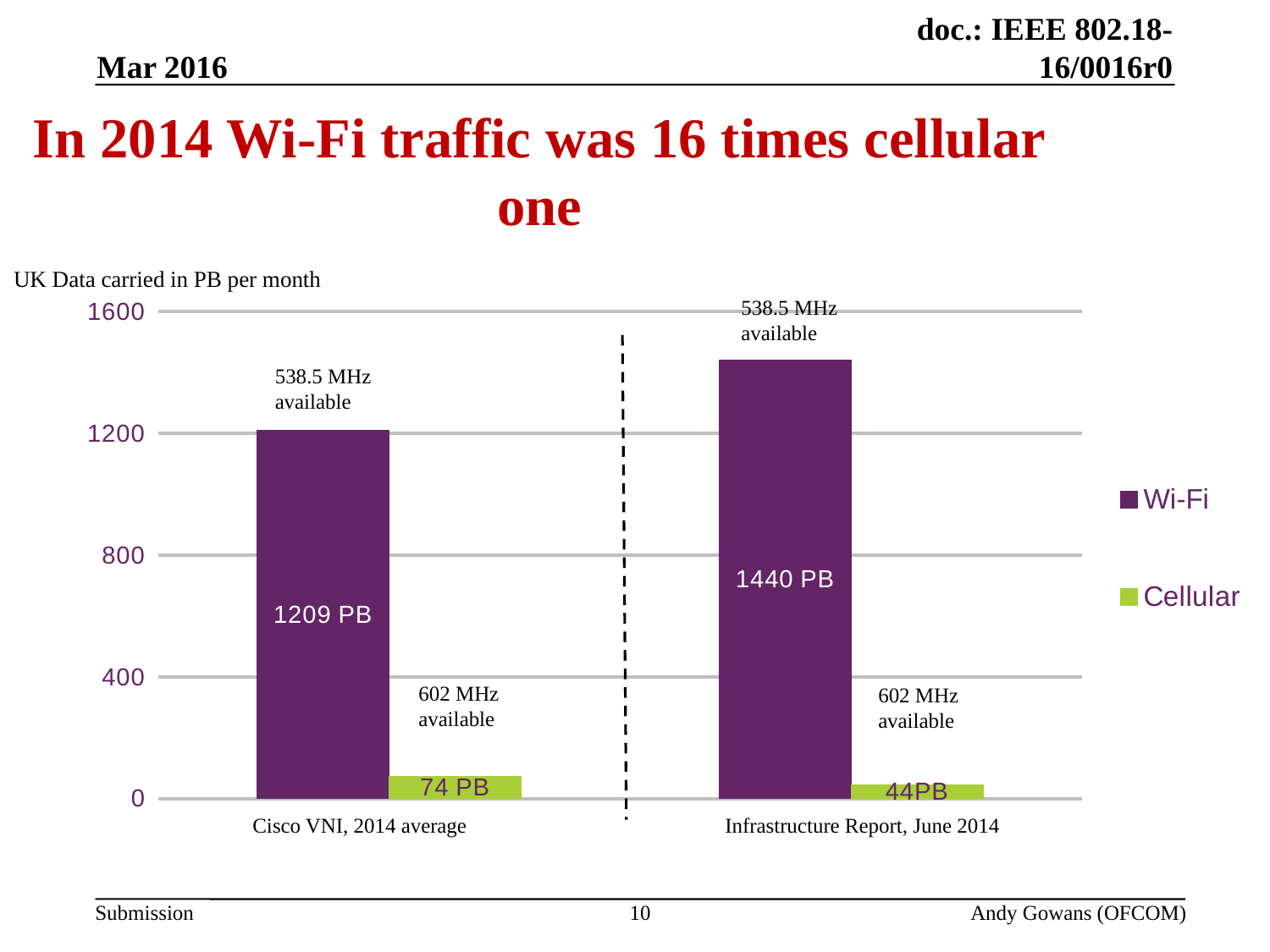
What is the Cellular value for Cisco VNI, 2014 average? 74 PB Which category has the lower Cellular value? Infrastructure Report, June 2014 Is the Wi-Fi value for Infrastructure Report, June 2014 greater or less than 1200? greater What is the Wi-Fi value for Cisco VNI, 2014 average? 1209 PB Is the Wi-Fi value for Cisco VNI, 2014 average larger than the Wi-Fi value for Infrastructure Report, June 2014? No What is the Wi-Fi value for Infrastructure Report, June 2014? 1440 PB Which category has the higher Wi-Fi value? Infrastructure Report, June 2014 What kind of chart is shown on the slide? Bar chart What is the Cellular value for Infrastructure Report, June 2014? 44PB What is the difference between the Wi-Fi and Cellular values for Cisco VNI, 2014 average? 1135 PB How many series does the legend list? 2 How many categories are shown on the x axis? 2